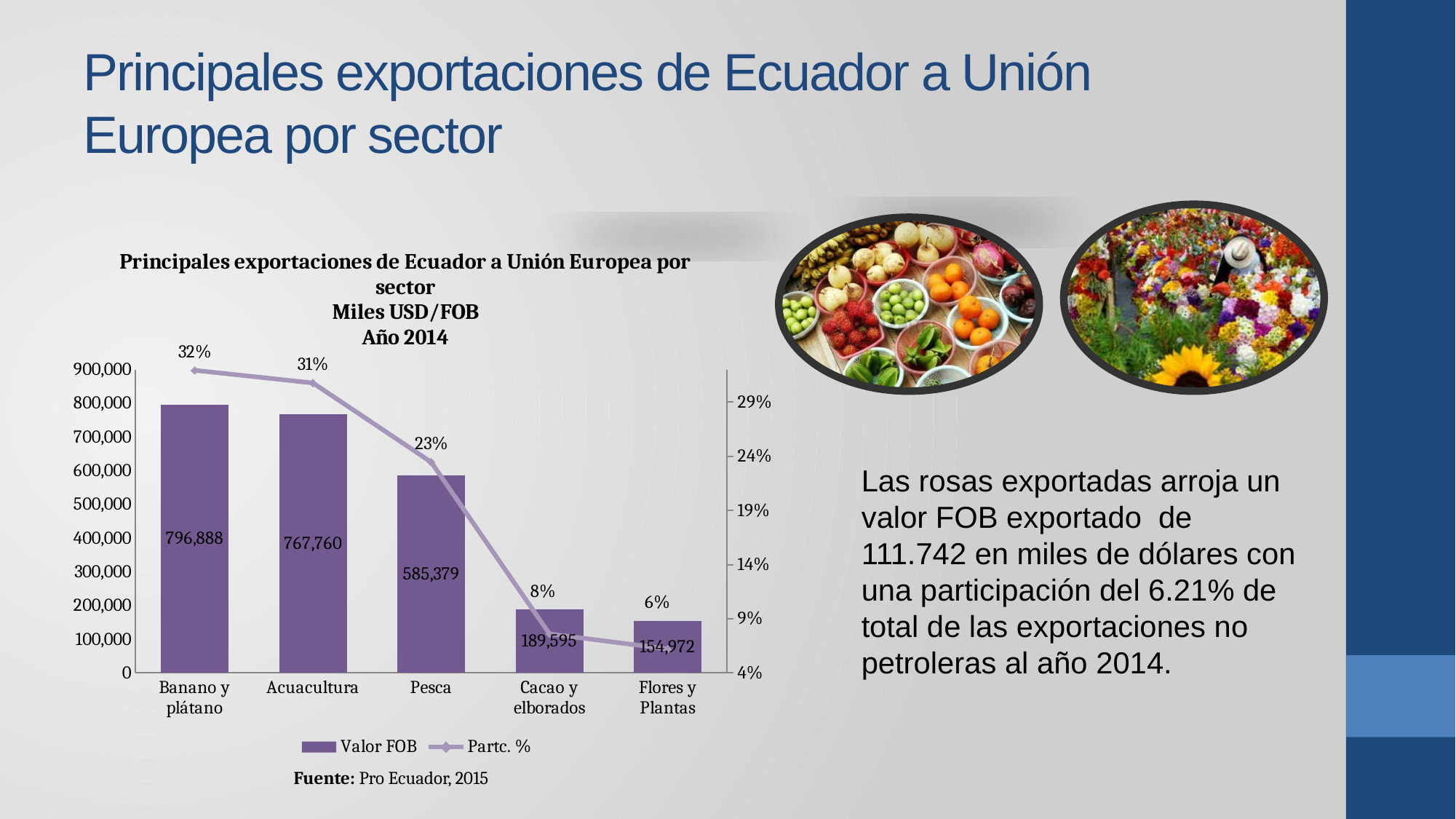
What kind of chart is used to show Valor FOB? Bar chart What is the Valor FOB for Banano y plátano? 796,888 Which has a larger Valor FOB, Cacao y elborados or Flores y Plantas? Cacao y elborados Which sector has the highest Valor FOB? Banano y plátano What is the Partc. % for Acuacultura? 31% How many series does the legend list? 2 Which sector has the lowest Valor FOB? Flores y Plantas What is the Partc. % for Flores y Plantas? 6% What is the difference in Valor FOB between Banano y plátano and Acuacultura? 29,128 How many sectors are shown on the x axis? 5 Do the Partc. % values rise or fall from left to right along the x axis? Fall What is the Valor FOB for Pesca? 585,379